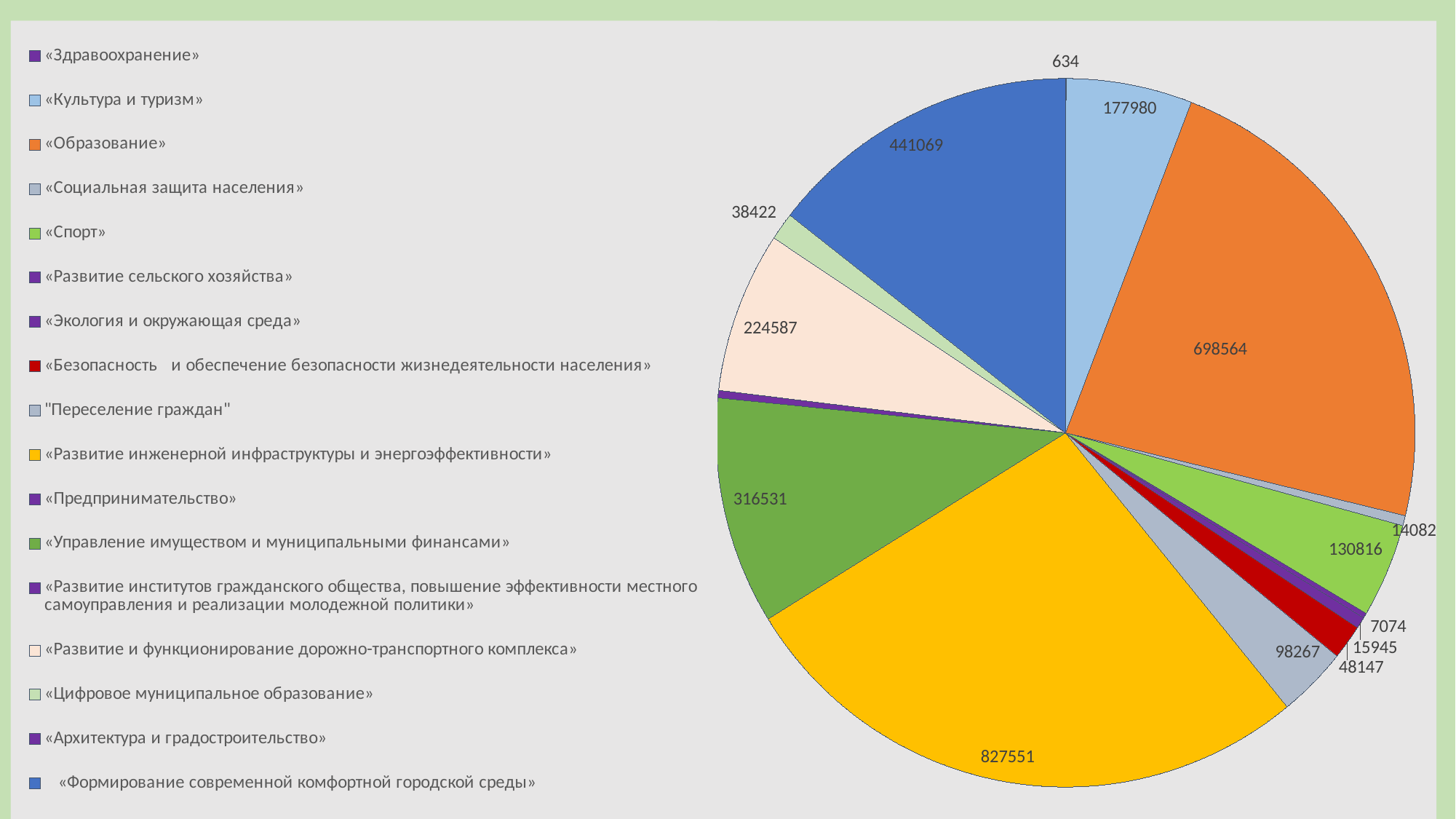
How many categories does the legend list? 17 What colour is the slice for «Развитие инженерной инфраструктуры и энергоэффективности»? yellow What is the value for «Образование»? 698564 What is the difference between the values for «Развитие инженерной инфраструктуры и энергоэффективности» and «Образование»? 128987 Which is larger, the value for «Образование» or the value for «Формирование современной комфортной городской среды»? «Образование» What is the value for «Управление имуществом и муниципальными финансами»? 316531 What is the value for «Развитие инженерной инфраструктуры и энергоэффективности»? 827551 What is the value for «Культура и туризм»? 177980 What type of chart is shown on the slide? pie chart What is the value for «Формирование современной комфортной городской среды»? 441069 Which category has the largest slice of the pie? «Развитие инженерной инфраструктуры и энергоэффективности» What is the value for «Цифровое муниципальное образование»? 38422